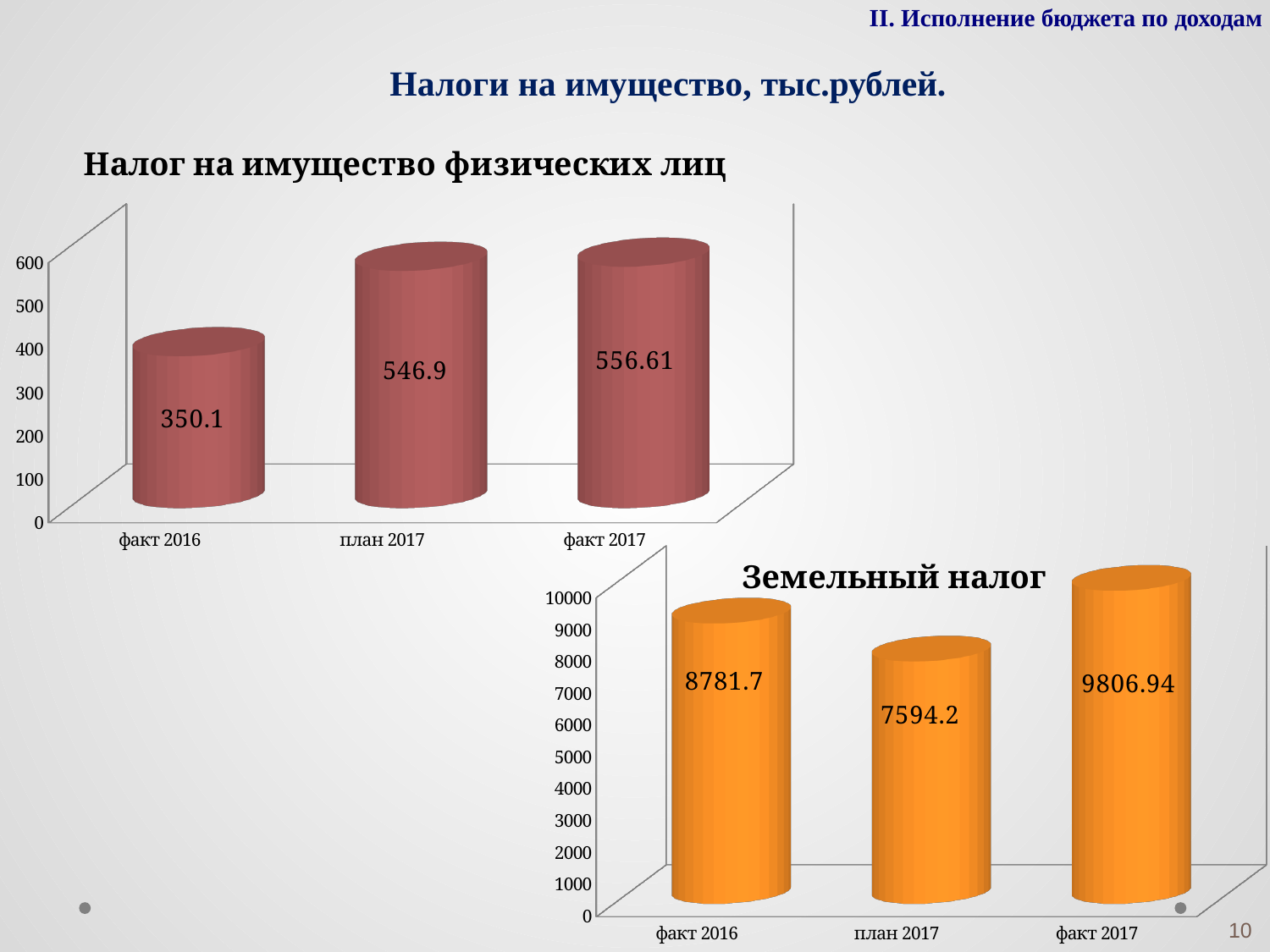
In the chart 'Налог на имущество физических лиц', what is the difference between факт 2017 and план 2017? 9.71 What colour are the bars in the chart 'Налог на имущество физических лиц'? red In the chart 'Налог на имущество физических лиц', how many bars are plotted? 3 In the chart 'Земельный налог', which category has the highest value? факт 2017 In the chart 'Земельный налог', which is larger: факт 2016 or план 2017? факт 2016 In the chart 'Земельный налог', what is the value for план 2017? 7594.2 In the chart 'Земельный налог', what is the difference between факт 2017 and факт 2016? 1025.24 In the chart 'Налог на имущество физических лиц', which category has the lowest value? факт 2016 In the chart 'Земельный налог', what is the value for факт 2017? 9806.94 What kind of chart is 'Земельный налог'? bar chart In the chart 'Налог на имущество физических лиц', what is the value for план 2017? 546.9 In the chart 'Налог на имущество физических лиц', what is the value for факт 2016? 350.1